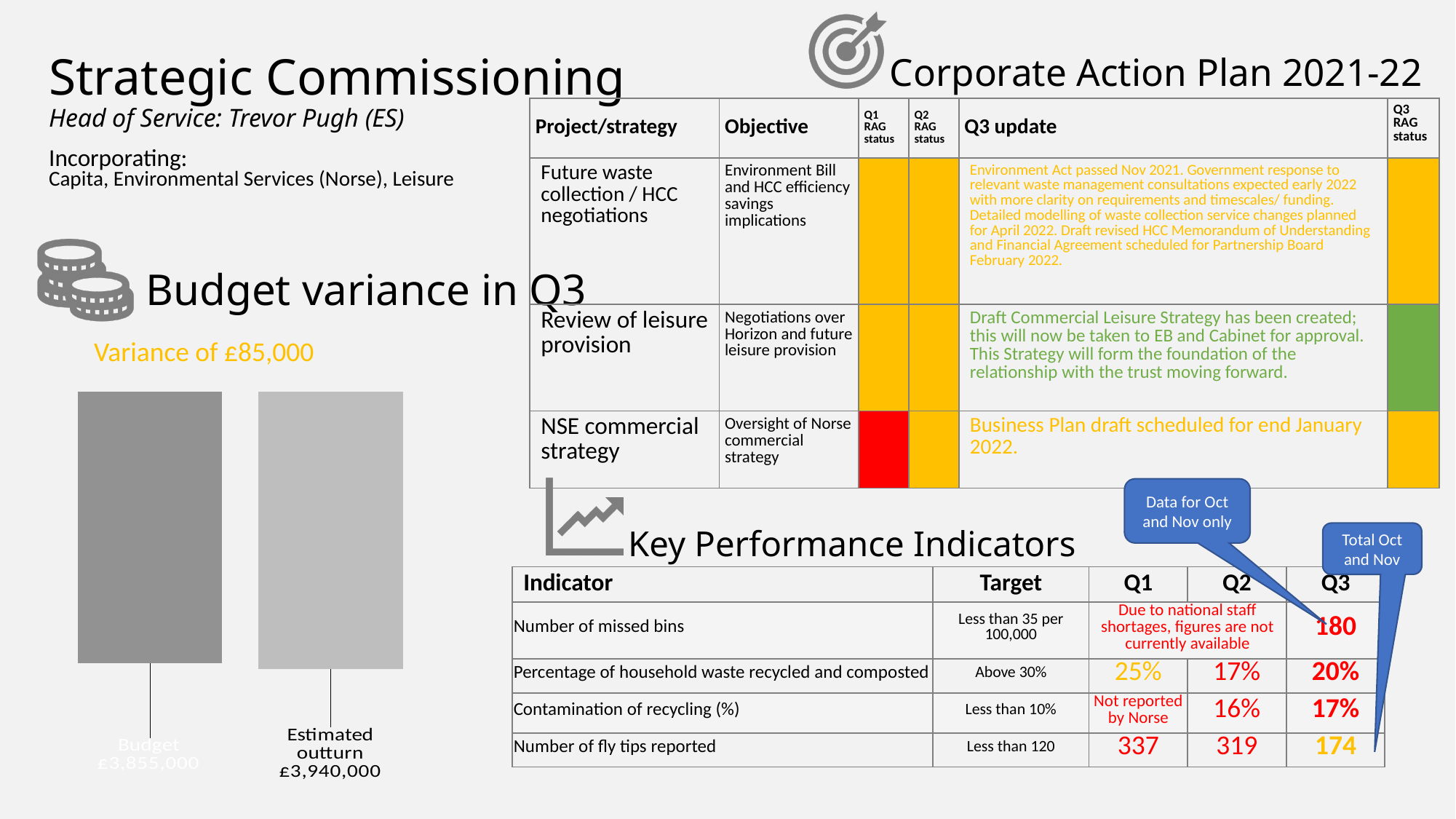
In the 'Budget variance in Q3' chart, what is the difference between the Estimated outturn and the Budget? £85,000 In the 'Budget variance in Q3' chart, do the values rise or fall from the Budget bar to the Estimated outturn bar? rise What is the title of the bar chart on the left of the slide? Budget variance in Q3 In the 'Budget variance in Q3' chart, which is larger, the Budget or the Estimated outturn? Estimated outturn How many bars does the 'Budget variance in Q3' chart show? 2 In the 'Budget variance in Q3' chart, what is the value of the Budget bar? £3,855,000 What kind of chart is shown under the heading 'Budget variance in Q3'? bar chart In the 'Budget variance in Q3' chart, what is the value of the Estimated outturn bar? £3,940,000 What variance amount is stated above the 'Budget variance in Q3' chart? Variance of £85,000 In the 'Budget variance in Q3' chart, which category has the highest value? Estimated outturn In the 'Budget variance in Q3' chart, which category has the lowest value? Budget